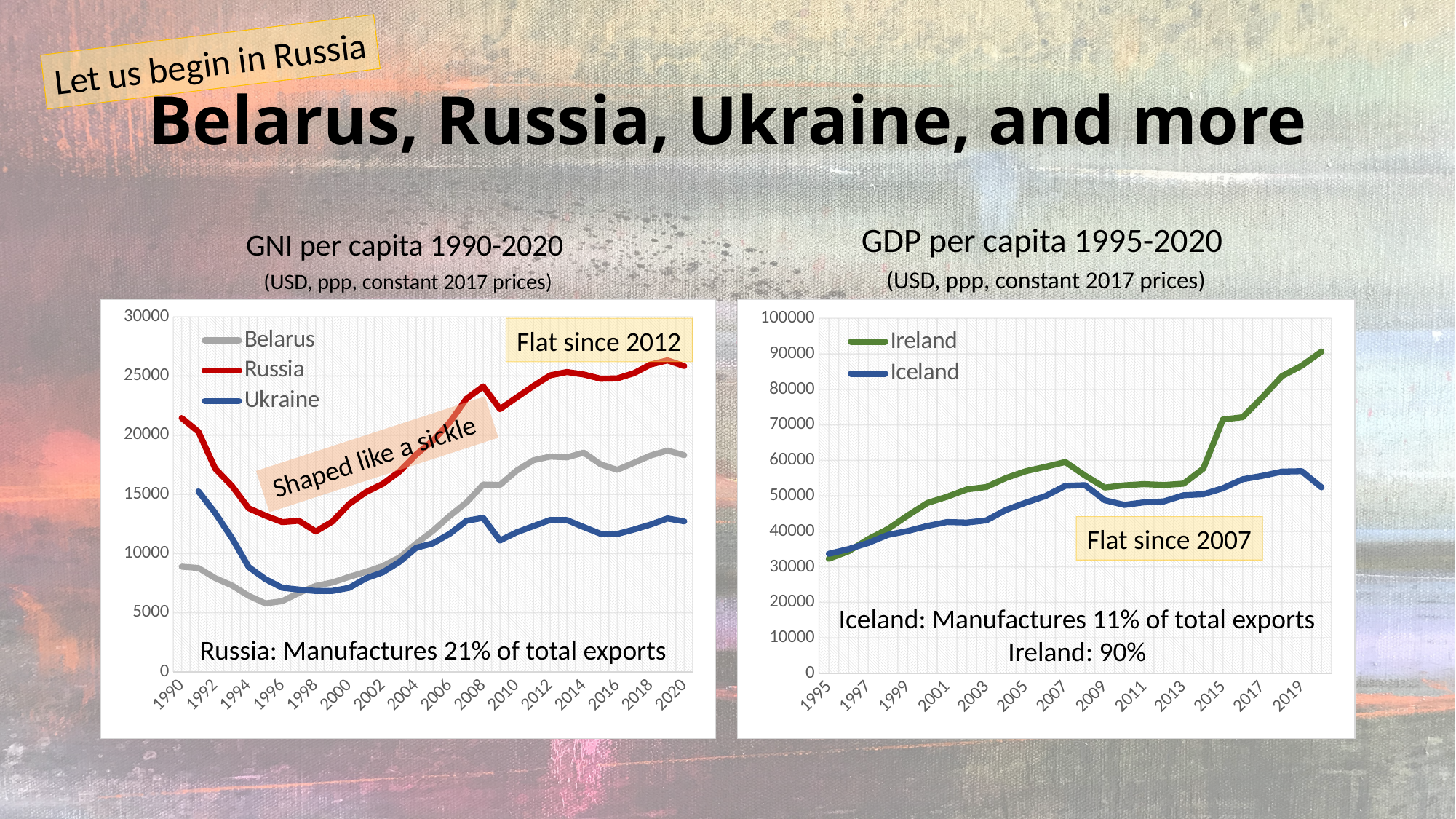
On the GDP per capita 1995-2020 chart, which colour is the Ireland line? Green On the GNI per capita 1990-2020 chart, which is larger in 2020, Belarus or Ukraine? Belarus On the GNI per capita 1990-2020 chart, does the value for Russia rise or fall from 1990 to 1998? Fall On the GNI per capita 1990-2020 chart, is the value for Russia in 1990 greater or less than 20000? greater What kind of chart is the GNI per capita 1990-2020 chart? Line chart On the GDP per capita 1995-2020 chart, how many series does the legend list? 2 On the GNI per capita 1990-2020 chart, is the value for Belarus in 1990 greater or less than 10000? less On the GNI per capita 1990-2020 chart, how many series does the legend list? 3 On the GNI per capita 1990-2020 chart, which series has the highest value in 2020? Russia On the GDP per capita 1995-2020 chart, is the value for Ireland in 2020 greater or less than 80000? greater On the GNI per capita 1990-2020 chart, which series has the lowest value in 1990? Belarus On the GDP per capita 1995-2020 chart, which is larger in 2020, Ireland or Iceland? Ireland